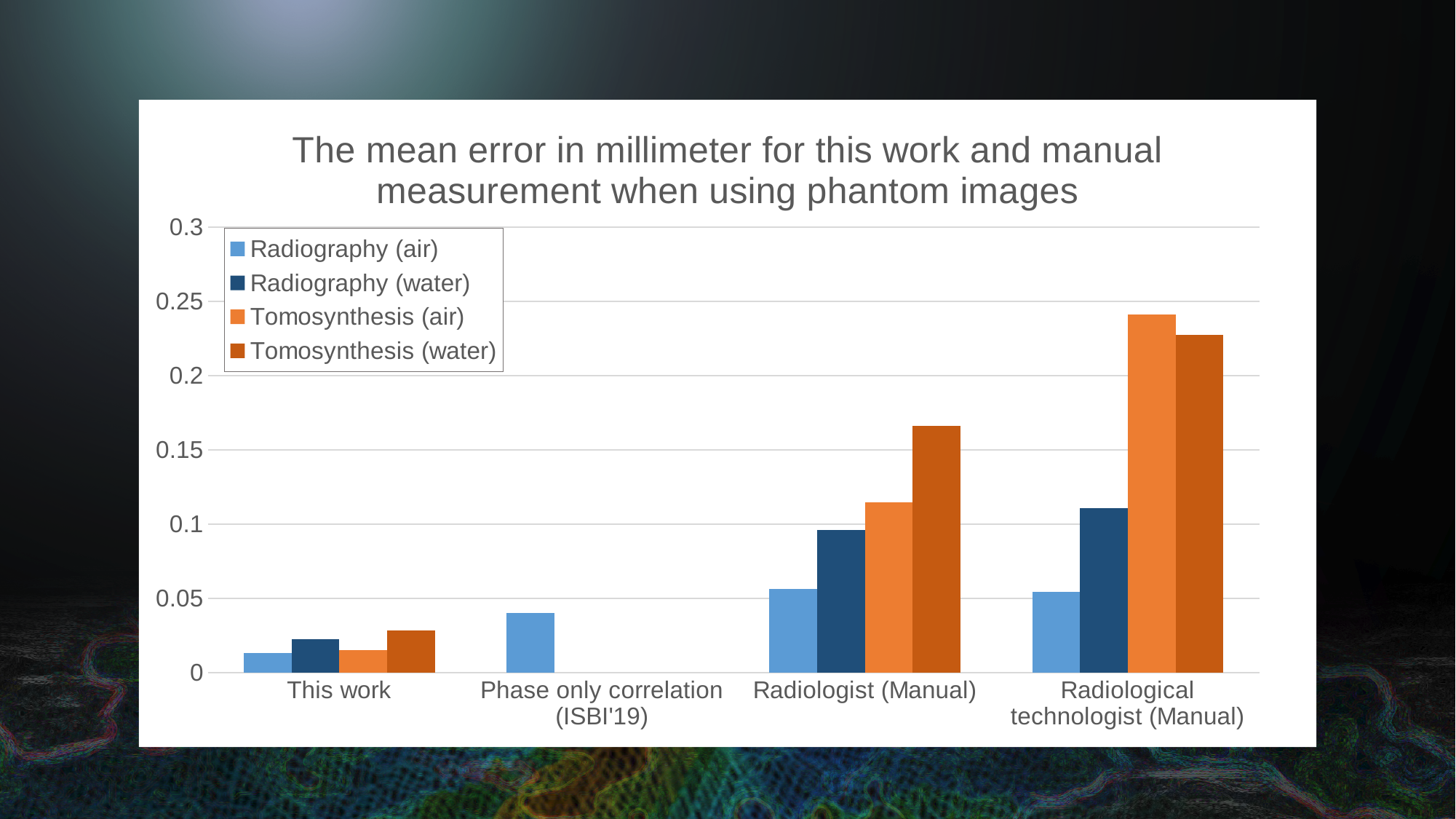
Is the Radiography (water) value for Radiological technologist (Manual) greater or less than 0.1? greater Which category has the highest value for Tomosynthesis (air)? Radiological technologist (Manual) How many series does the legend list? 4 What kind of chart is shown on the slide? bar chart Which category has the lowest value for Tomosynthesis (water)? This work How many categories are shown on the x axis? 4 Which category has only a single bar plotted? Phase only correlation (ISBI'19) Is the Tomosynthesis (water) value for Radiologist (Manual) greater or less than 0.15? greater What is the title of the chart? The mean error in millimeter for this work and manual measurement when using phantom images For Radiologist (Manual), which is larger: Radiography (air) or Radiography (water)? Radiography (water) Is the Radiography (air) value for Phase only correlation (ISBI'19) greater or less than 0.05? less For Radiological technologist (Manual), which is larger: Tomosynthesis (air) or Tomosynthesis (water)? Tomosynthesis (air)